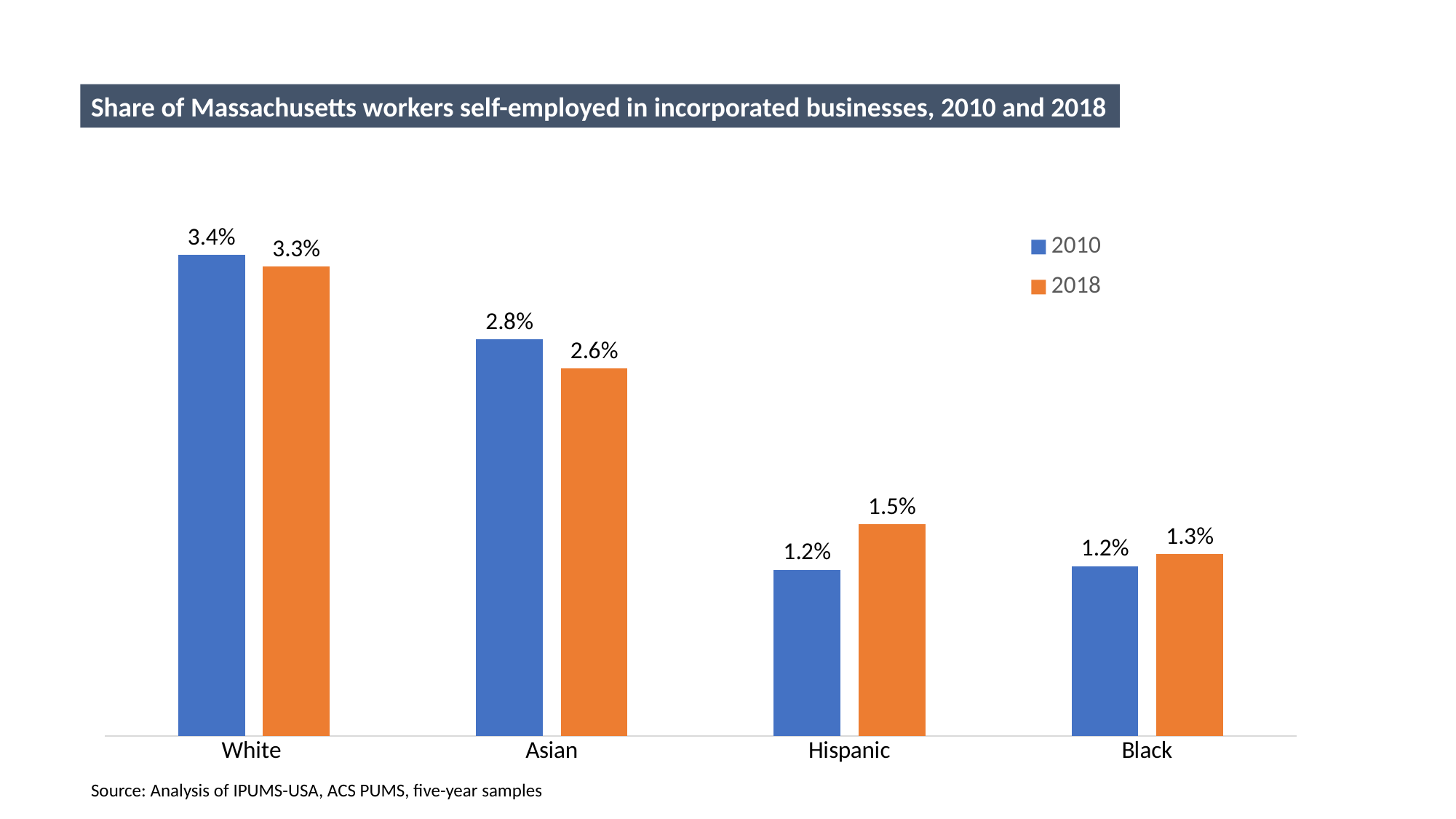
What was the share of White Massachusetts workers self-employed in incorporated businesses in 2010? 3.4% For Hispanic workers, was the share higher in 2010 or 2018? 2018 What was the share of Black workers self-employed in incorporated businesses in 2010? 1.2% What is the difference between the White and Hispanic shares in 2010? 2.2% What was the share of Hispanic workers self-employed in incorporated businesses in 2018? 1.5% What was the share of Asian workers self-employed in incorporated businesses in 2018? 2.6% How many series does the legend list? 2 How many racial/ethnic groups are shown on the chart? 4 What is the difference between the 2010 and 2018 shares for Asian workers? 0.2% Which group had the lowest share of workers self-employed in incorporated businesses in 2018? Black What type of chart is shown on the slide? Bar chart Which group had the highest share of workers self-employed in incorporated businesses in 2018? White